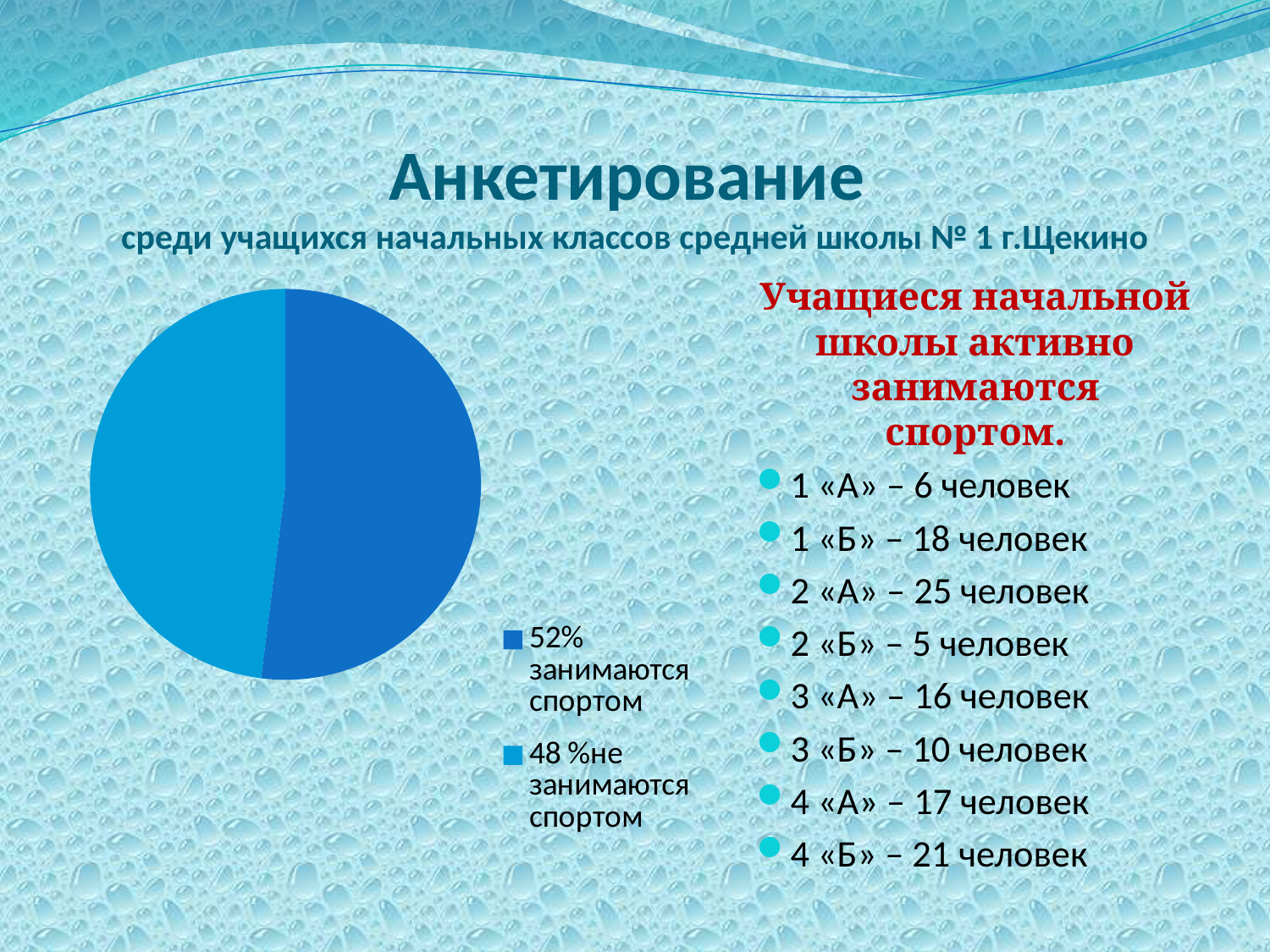
What kind of chart is shown on the slide? pie chart What is the difference in percentage points between the two slices of the pie chart? 4 How many entries does the legend of the pie chart list? 2 What colour is the slice for students who do not do sports (не занимаются спортом)? light blue Which slice of the pie chart is larger: занимаются спортом or не занимаются спортом? занимаются спортом What share of the pie corresponds to students who do not do sports (не занимаются спортом)? 48 % Which legend entry represents the smallest slice of the pie chart? 48 %не занимаются спортом Is the share of students who do sports greater or less than 50%? greater What is the main title at the top of the slide? Анкетирование What share of the pie corresponds to students who do sports (занимаются спортом)? 52% Which legend entry represents the largest slice of the pie chart? 52% занимаются спортом How many slices does the pie chart have? 2